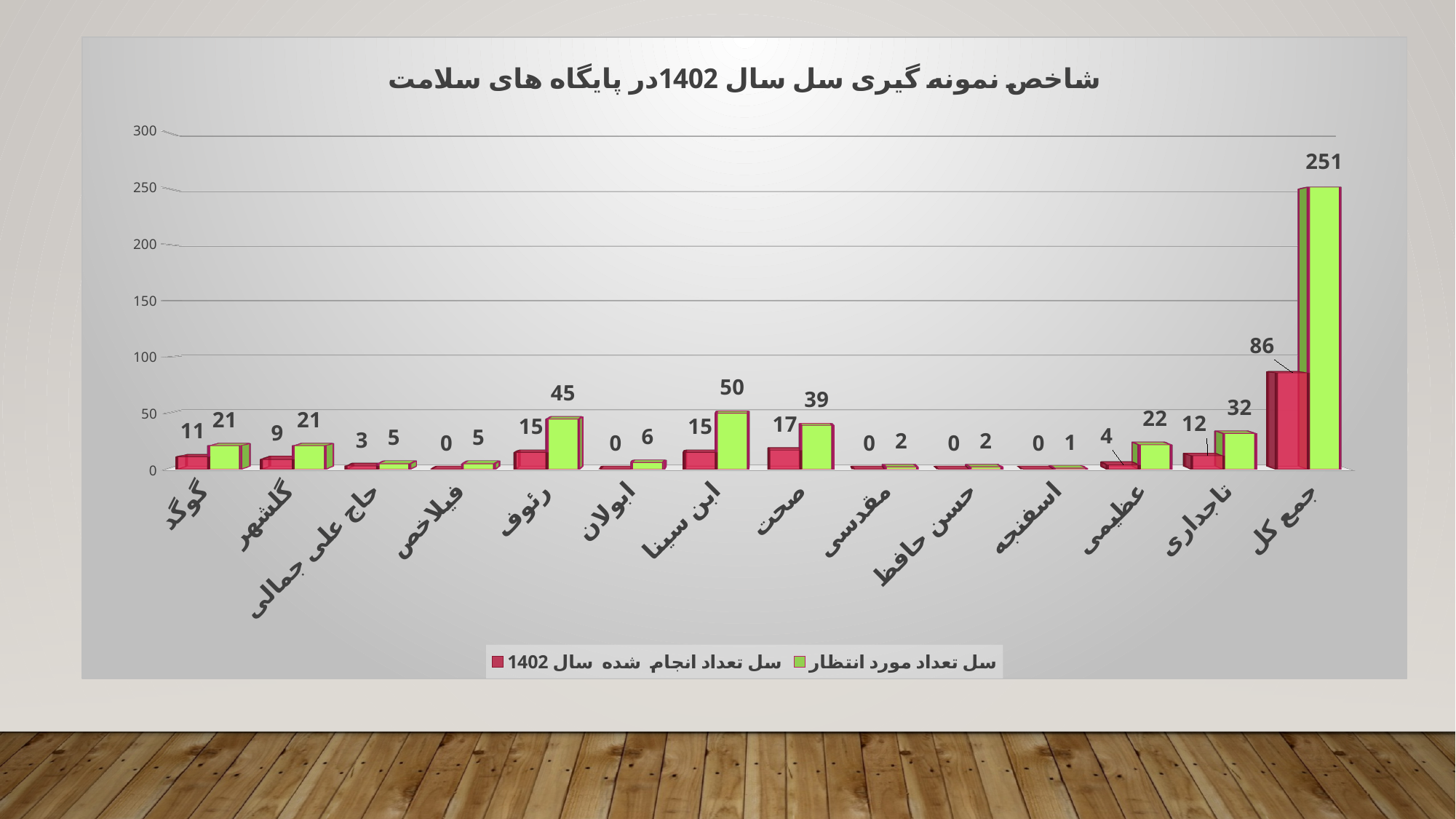
What is the difference between the expected and performed values for جمع کل? 165 What is the performed TB sample count for 1402 (سل تعداد انجام شده سال 1402) for تاجداری? 12 Which station has the lowest expected value (سل تعداد مورد انتظار)? اسفنجه How many series does the legend list? 2 What kind of chart is shown on the slide? Bar chart Excluding جمع کل, which station has the highest expected value (سل تعداد مورد انتظار)? ابن سینا What is the expected TB sample count (سل تعداد مورد انتظار) for ابن سینا? 50 How many stations (categories) are shown on the x axis? 14 What is the performed value for 1402 for جمع کل? 86 What is the expected value (سل تعداد مورد انتظار) for رئوف? 45 Which is larger: the performed value for 1402 for گوگد or for گلشهر? گوگد What is the difference between the expected and performed values for صحت? 22